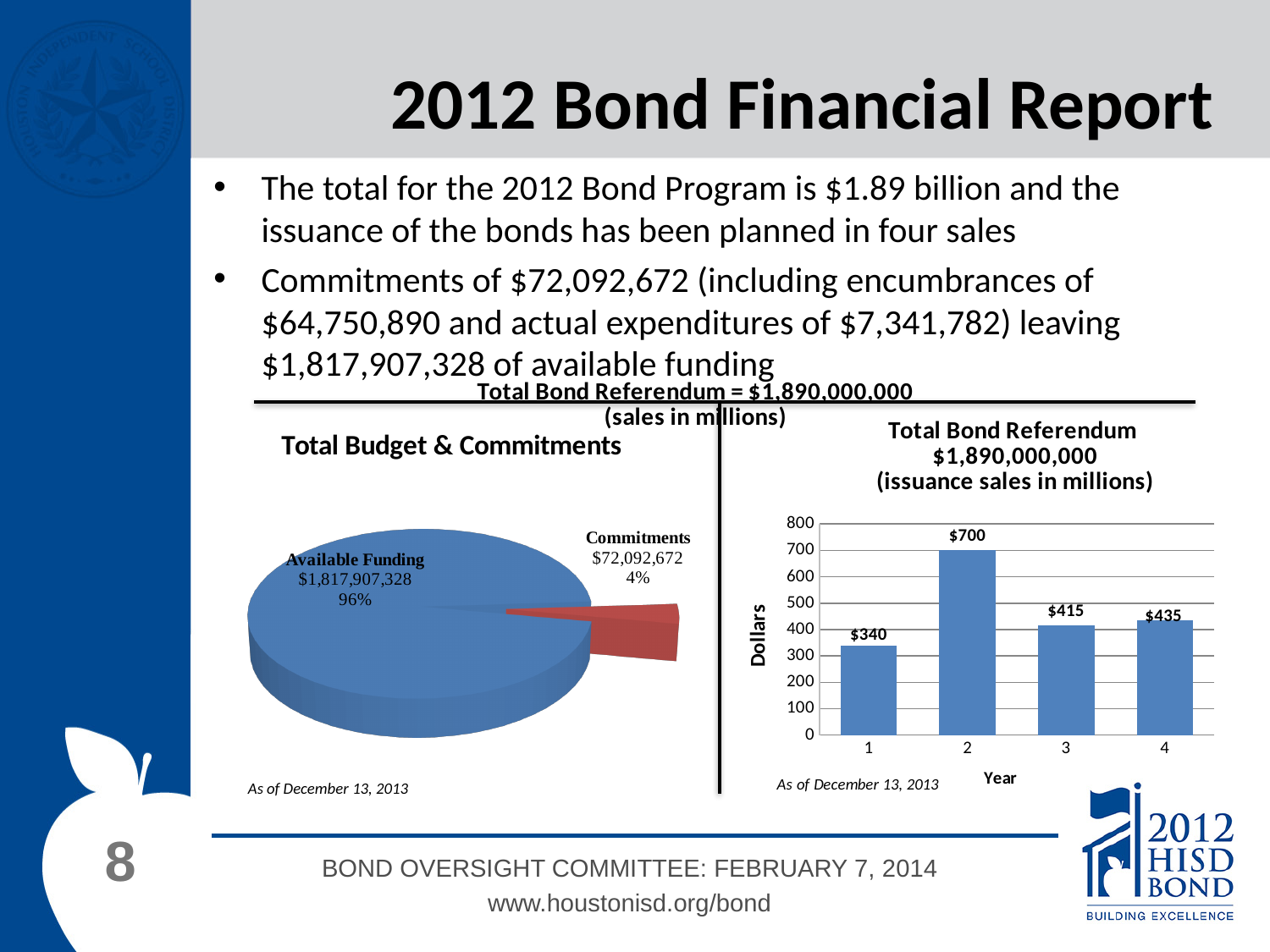
In the Total Bond Referendum bar chart, which is larger, the value for Year 3 or Year 4? Year 4 In the Total Bond Referendum bar chart, which year has the lowest issuance sales? 1 In the Total Bond Referendum bar chart, which year has the highest issuance sales? 2 In the Total Bond Referendum bar chart, how many years are shown on the x axis? 4 In the Total Bond Referendum bar chart, what is the value for Year 4? $435 In the Total Bond Referendum bar chart, what is the difference between the values for Year 2 and Year 1? $360 What kind of chart is the Total Bond Referendum chart on the right? Bar chart In the Total Bond Referendum bar chart, what is the value for Year 1? $340 In the Total Budget & Commitments pie chart, what is the value for Commitments? $72,092,672 In the Total Budget & Commitments pie chart, what share does Available Funding represent? 96% What is the label on the y axis of the Total Bond Referendum bar chart? Dollars In the Total Bond Referendum bar chart, what is the value for Year 2? $700